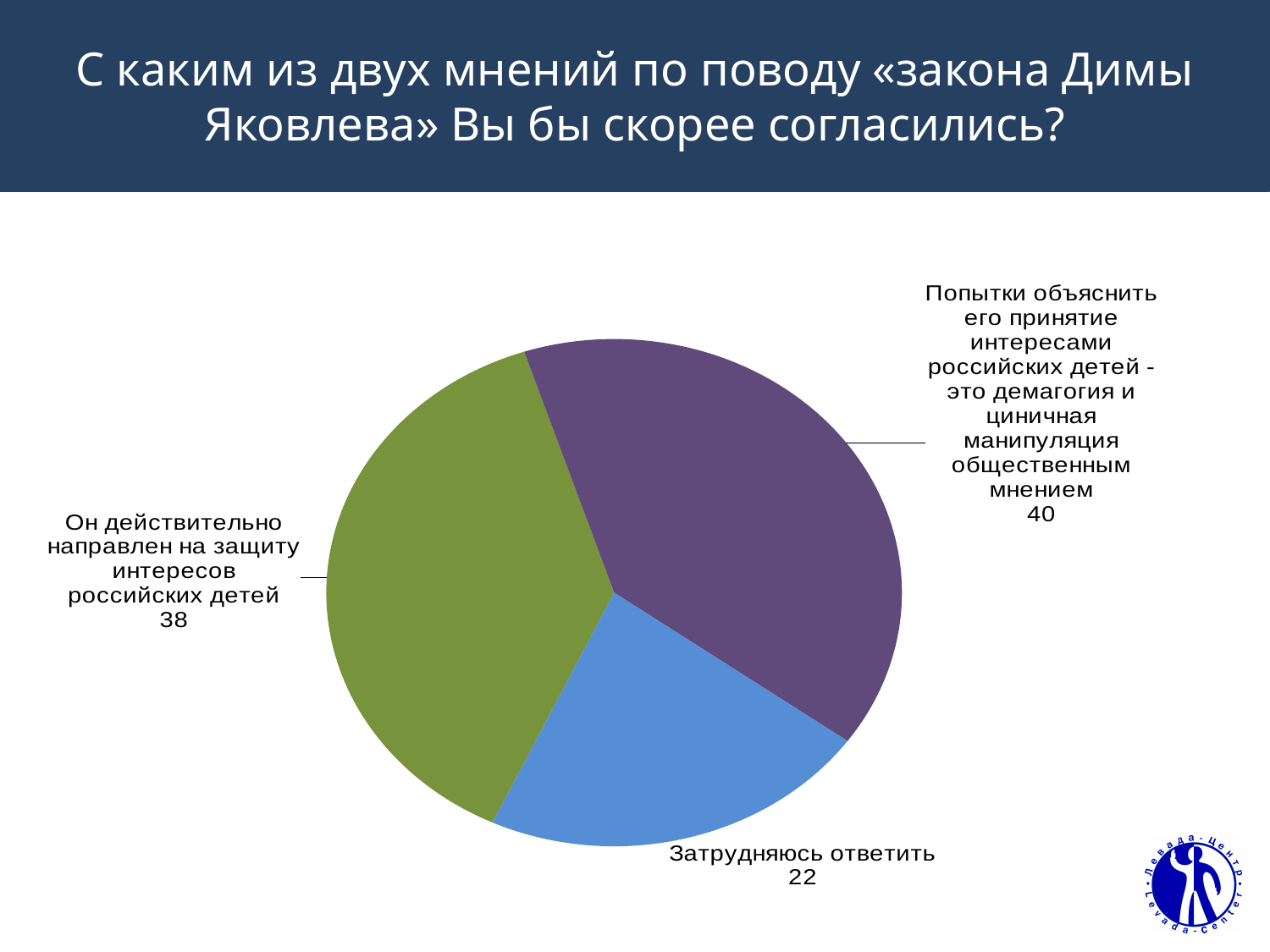
What type of chart is shown on the slide? Pie chart What is the value for "Затрудняюсь ответить"? 22 Which slice has the largest value? Попытки объяснить его принятие интересами российских детей - это демагогия и циничная манипуляция общественным мнением What is the title of the slide containing the pie chart? С каким из двух мнений по поводу «закона Димы Яковлева» Вы бы скорее согласились? Which is larger: the value for "Он действительно направлен на защиту интересов российских детей" or the value for "Затрудняюсь ответить"? Он действительно направлен на защиту интересов российских детей What is the difference between the value for "Он действительно направлен на защиту интересов российских детей" and the value for "Затрудняюсь ответить"? 16 What is the difference between the value for "Попытки объяснить его принятие интересами российских детей - это демагогия и циничная манипуляция общественным мнением" and the value for "Он действительно направлен на защиту интересов российских детей"? 2 What is the value for the slice labelled "Попытки объяснить его принятие интересами российских детей - это демагогия и циничная манипуляция общественным мнением"? 40 How many slices does the pie chart have? 3 What is the value for "Он действительно направлен на защиту интересов российских детей"? 38 What colour is the slice for "Затрудняюсь ответить"? Blue Which slice has the smallest value? Затрудняюсь ответить